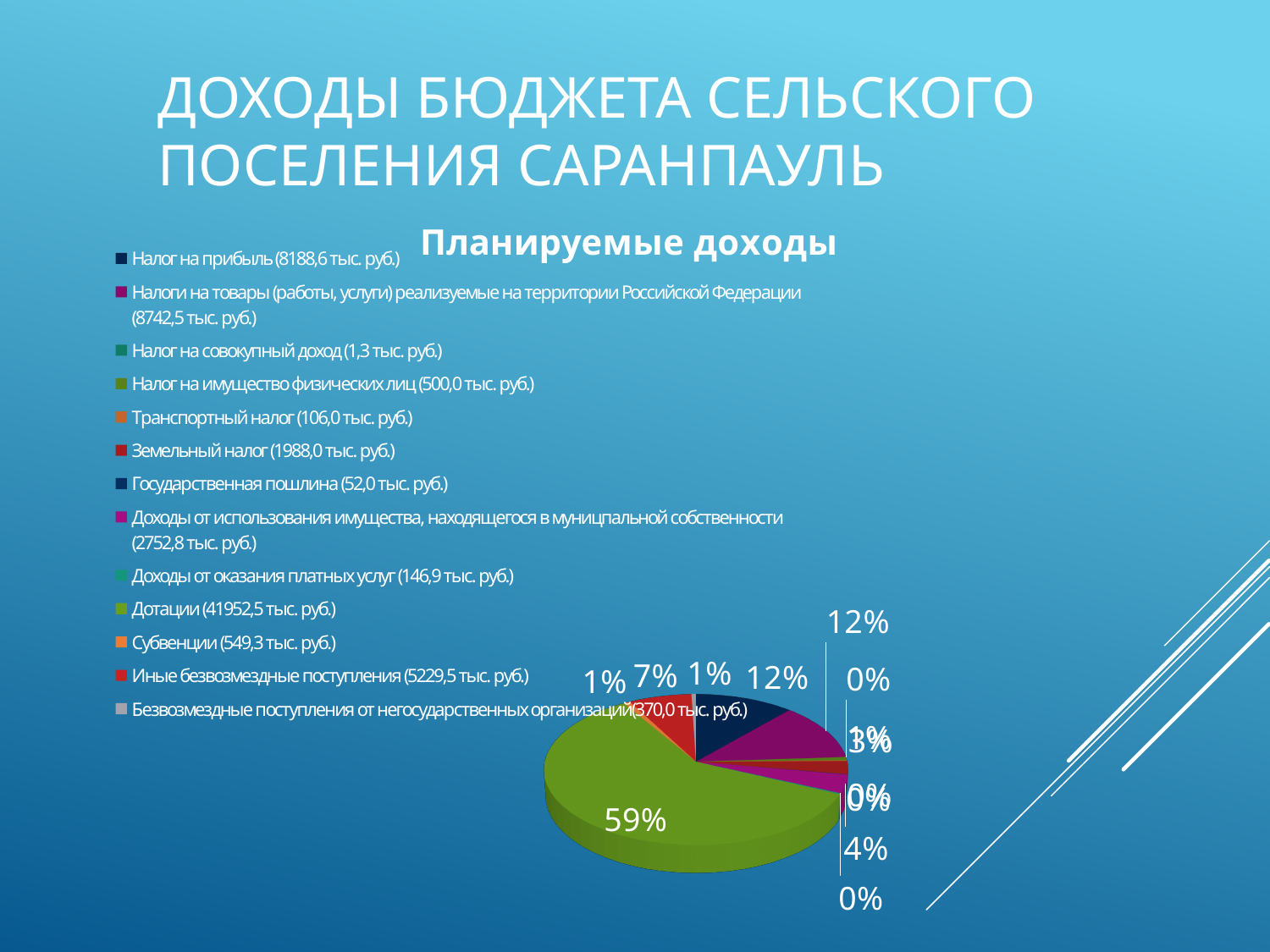
Which category has the largest slice of the pie? Дотации Which is larger according to the legend: Налог на прибыль or Налоги на товары (работы, услуги) реализуемые на территории Российской Федерации? Налоги на товары (работы, услуги) реализуемые на территории Российской Федерации Which category has the smallest amount in the legend? Налог на совокупный доход What amount is given in the legend for Дотации? 41952,5 тыс. руб. How many categories does the chart's legend list? 13 What is the title of the chart? Планируемые доходы What kind of chart is shown on the slide? pie chart What share of the pie does Налог на прибыль take? 12% What share of the pie does Дотации take? 59% What amount is given in the legend for Земельный налог? 1988,0 тыс. руб. What amount is given in the legend for Транспортный налог? 106,0 тыс. руб. What share of the pie does Иные безвозмездные поступления take? 7%